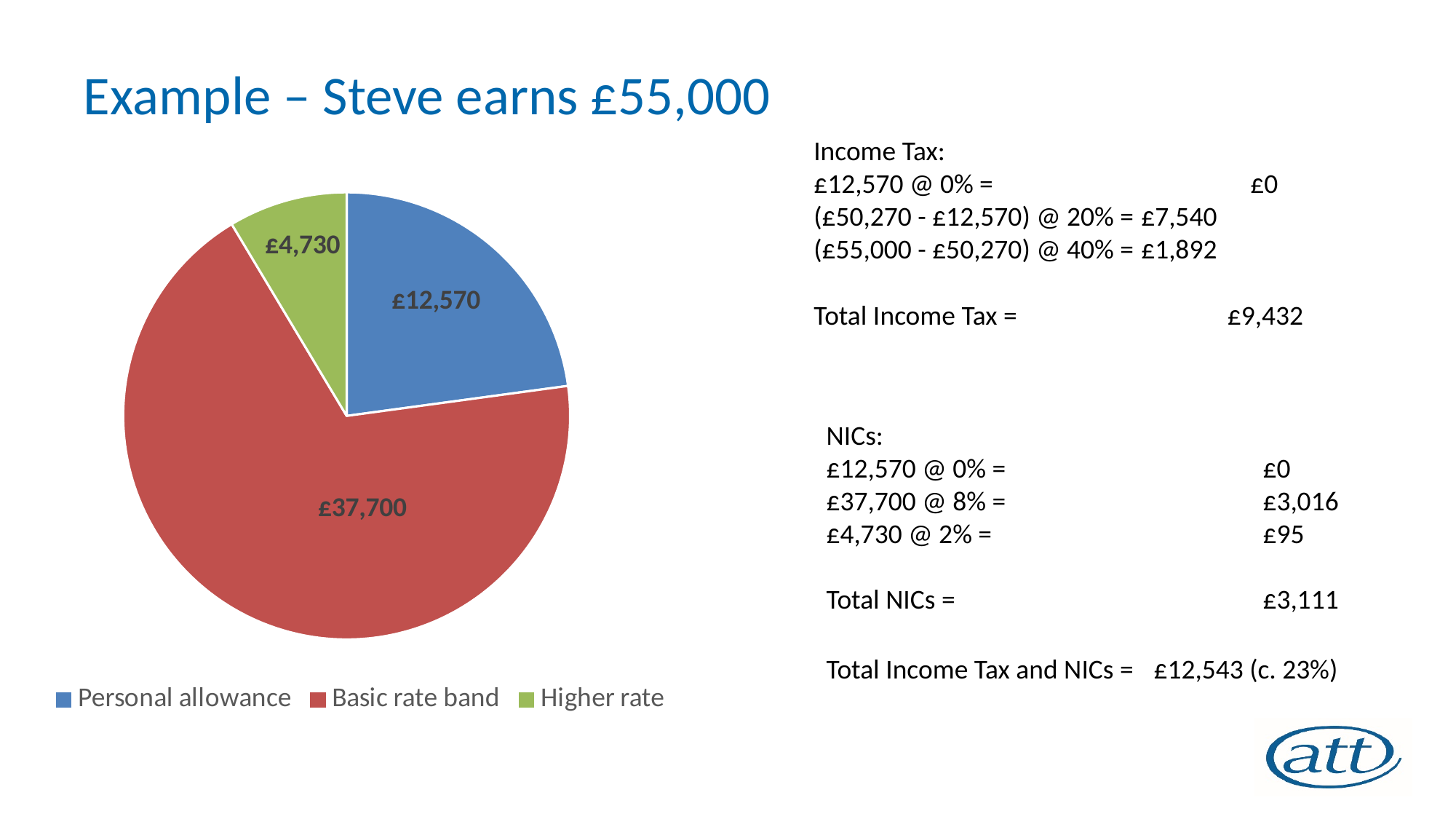
What is the value of the Higher rate slice? £4,730 Which slice of the pie chart is the largest? Basic rate band How many slices does the pie chart have? 3 What is the total of all the slices in the pie chart? £55,000 What is the value of the Basic rate band slice? £37,700 What type of chart is shown on the slide? Pie chart What colour is the Basic rate band slice? Red What is the value of the Personal allowance slice? £12,570 Which is larger, the Personal allowance slice or the Higher rate slice? Personal allowance What is the difference between the Personal allowance and Higher rate values? £7,840 What is the difference between the Basic rate band and Personal allowance values? £25,130 Which slice of the pie chart is the smallest? Higher rate